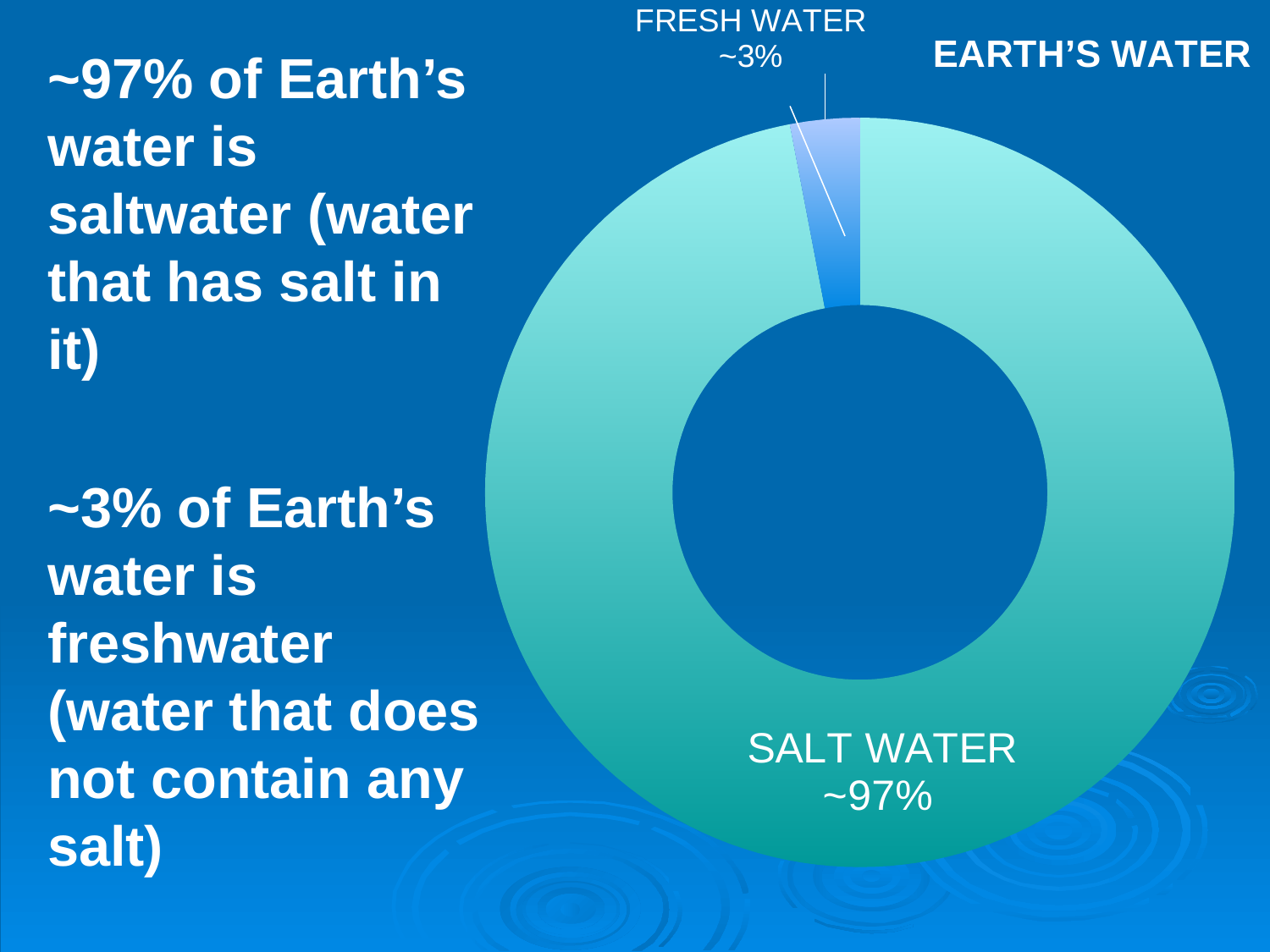
What is the label printed on the large teal slice of the chart? SALT WATER ~97% What share of Earth's water does the chart show as fresh water? ~3% What share of Earth's water does the chart show as salt water? ~97% Which slice of the Earth's Water chart is the smallest? Fresh Water By how many percentage points does the salt water share exceed the fresh water share in the chart? 94 percentage points What is the label printed for the small blue slice of the chart? FRESH WATER ~3% Which is larger in the chart, the salt water slice or the fresh water slice? Salt Water What is the title of the chart on the slide? EARTH'S WATER Which slice of the Earth's Water chart is the largest? Salt Water What kind of chart is shown on the slide? doughnut chart How many slices does the Earth's Water chart have? 2 What colour is the fresh water slice in the chart? blue